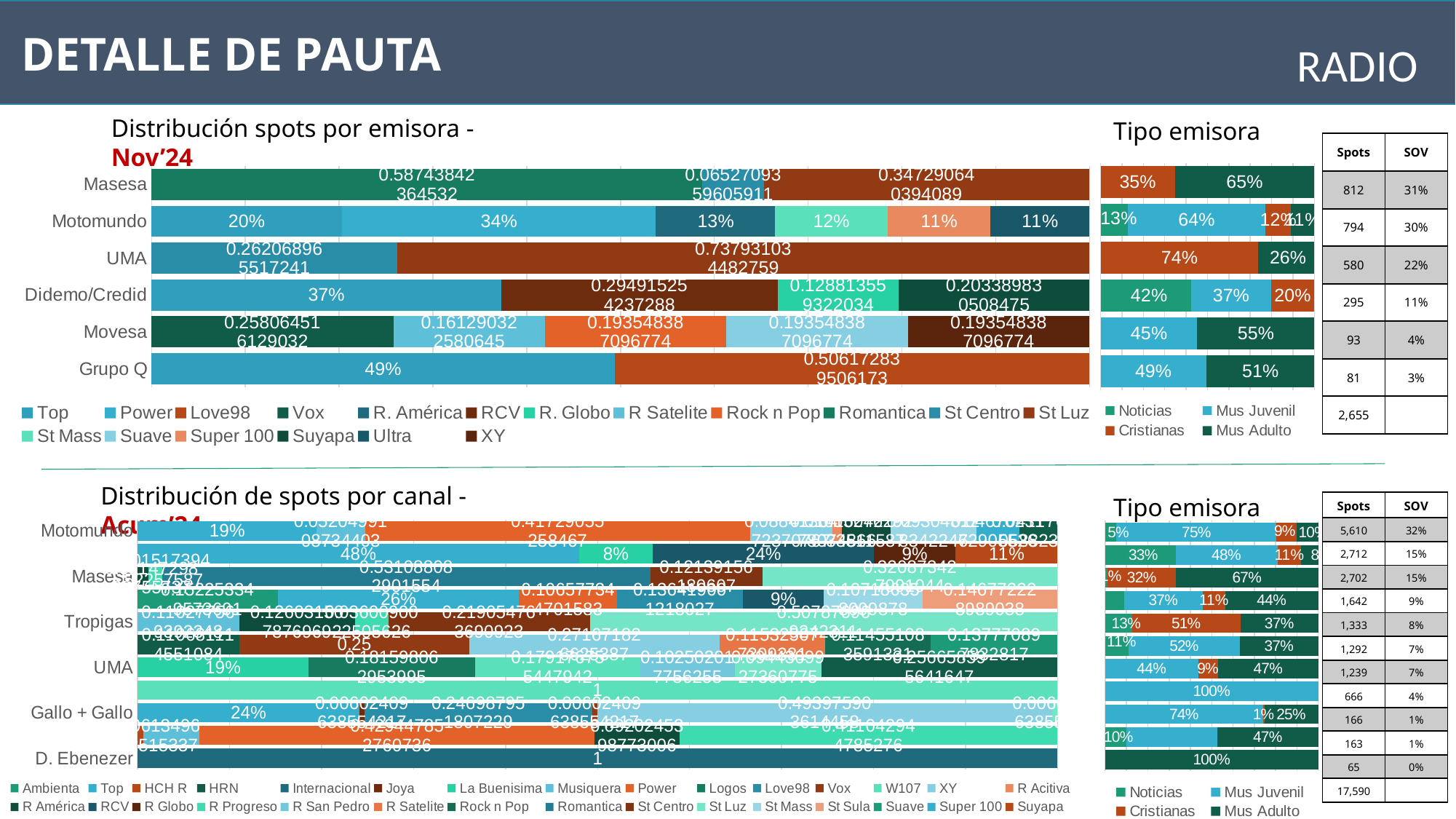
In the top chart 'Distribución spots por emisora - Nov'24', what is the value of the Power series for Motomundo? 34% What kind of chart is the top 'Distribución spots por emisora - Nov'24' chart? Stacked bar chart In the top chart 'Distribución spots por emisora - Nov'24', what is the value of the first (Top) segment for Grupo Q? 49% In the top 'Tipo emisora' chart, what is the Cristianas share for UMA? 74% In the top 'Tipo emisora' chart, what is the Noticias share for Didemo/Credid? 42% In the top 'Tipo emisora' chart, what is the difference between the Mus Adulto and Mus Juvenil shares for Movesa? 10% How many emisoras (categories) are shown in the top chart 'Distribución spots por emisora - Nov'24'? 6 In the top 'Tipo emisora' chart, which emisora has the highest Cristianas share? UMA How many series does the legend of the top chart 'Distribución spots por emisora - Nov'24' list? 18 How many series does the legend of the top 'Tipo emisora' chart list? 4 In the top chart 'Distribución spots por emisora - Nov'24', what is the value of the Top series for Motomundo? 20% In the top 'Tipo emisora' chart, what is the Mus Adulto share for Masesa? 65%